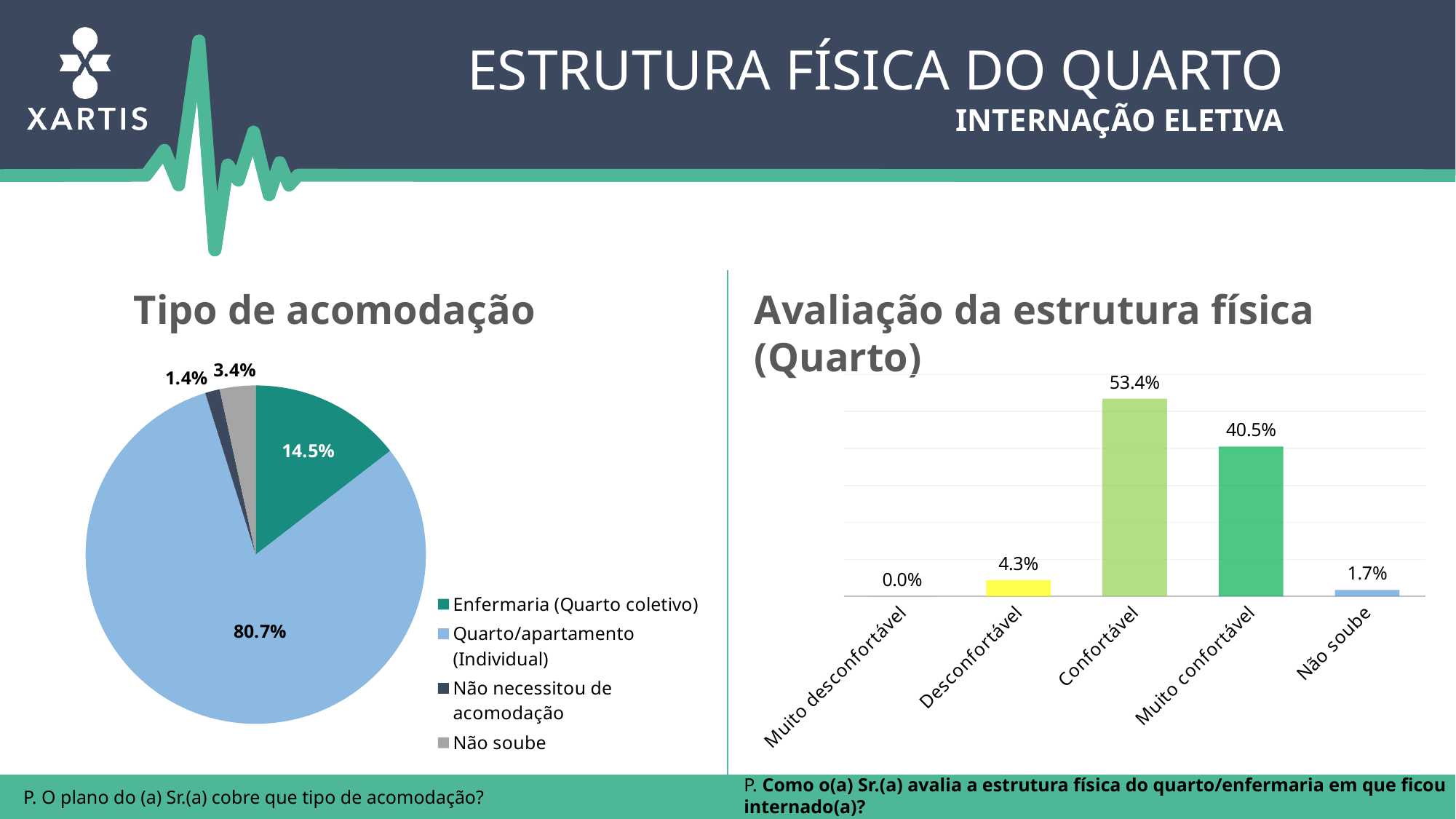
In the 'Avaliação da estrutura física (Quarto)' chart, what is the difference between Confortável and Muito confortável? 12.9% In the 'Tipo de acomodação' chart, what share is Quarto/apartamento (Individual)? 80.7% In the 'Avaliação da estrutura física (Quarto)' chart, which is larger: Desconfortável or Não soube? Desconfortável What kind of chart is 'Tipo de acomodação'? Pie chart In the 'Avaliação da estrutura física (Quarto)' chart, what is the value for Confortável? 53.4% In the 'Tipo de acomodação' chart, which category has the smallest slice? Não necessitou de acomodação What kind of chart is 'Avaliação da estrutura física (Quarto)'? Bar chart In the 'Avaliação da estrutura física (Quarto)' chart, what is the value for Muito desconfortável? 0.0% In the 'Tipo de acomodação' chart, how many categories does the legend list? 4 In the 'Tipo de acomodação' chart, what share is Enfermaria (Quarto coletivo)? 14.5% In the 'Avaliação da estrutura física (Quarto)' chart, which category has the highest value? Confortável In the 'Tipo de acomodação' chart, what is the difference between Quarto/apartamento (Individual) and Enfermaria (Quarto coletivo)? 66.2%